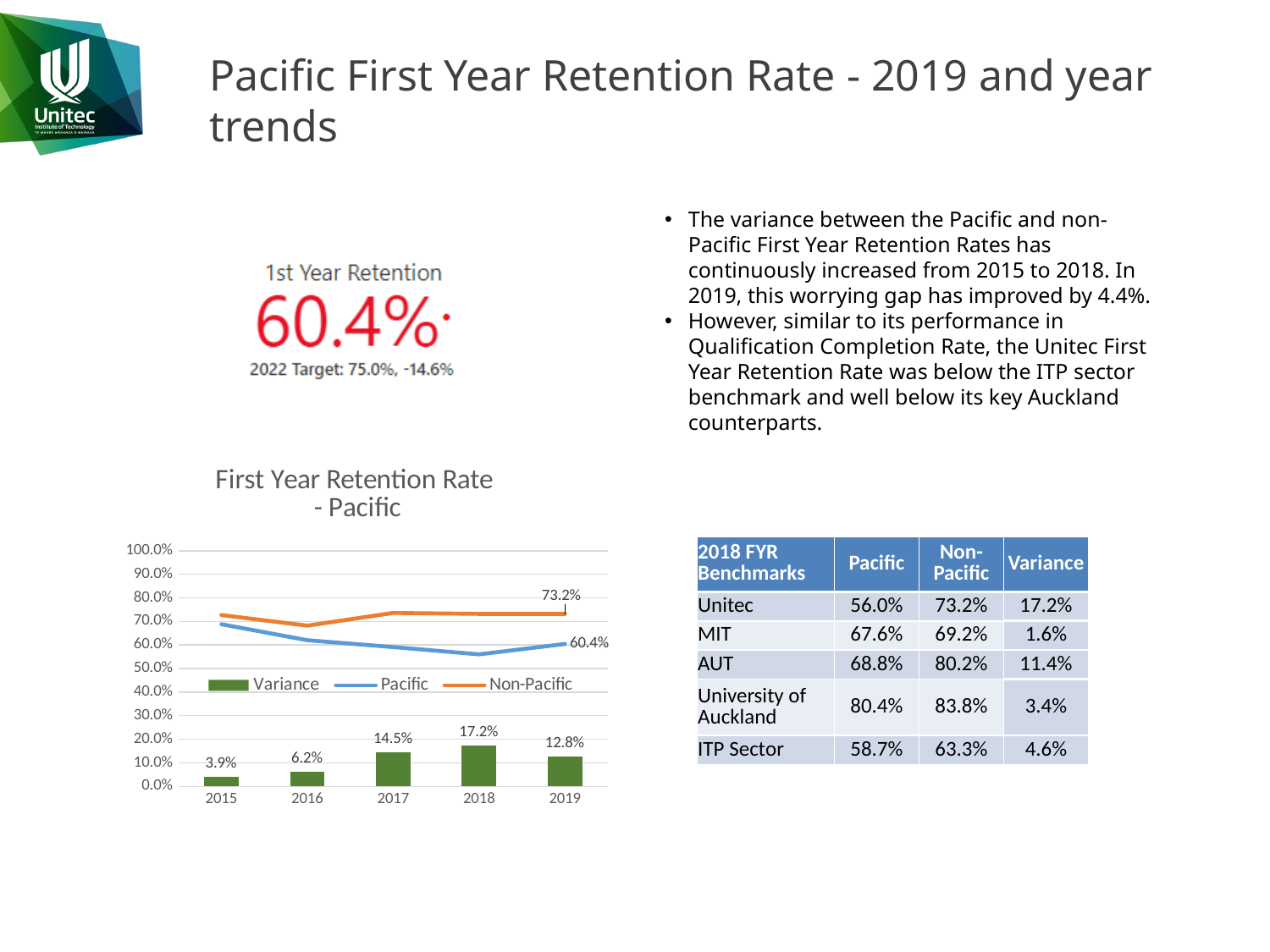
How many years are shown on the x axis of the chart? 5 In which year is the Variance bar lowest? 2015 Is the Pacific retention rate for 2015 greater or less than 60.0%? greater What is the Variance value for 2015 in the First Year Retention Rate - Pacific chart? 3.9% What is the Variance value for 2018 in the First Year Retention Rate - Pacific chart? 17.2% What is the Non-Pacific retention rate shown for 2019 in the chart? 73.2% Did the Variance rise or fall from 2015 to 2018? rise By how much did the Variance decrease from 2018 to 2019? 4.4% What is the difference between the Non-Pacific and Pacific rates in 2019? 12.8% How many series does the chart legend list? 3 In which year is the Variance bar highest? 2018 What is the Pacific retention rate shown for 2019 in the chart? 60.4%